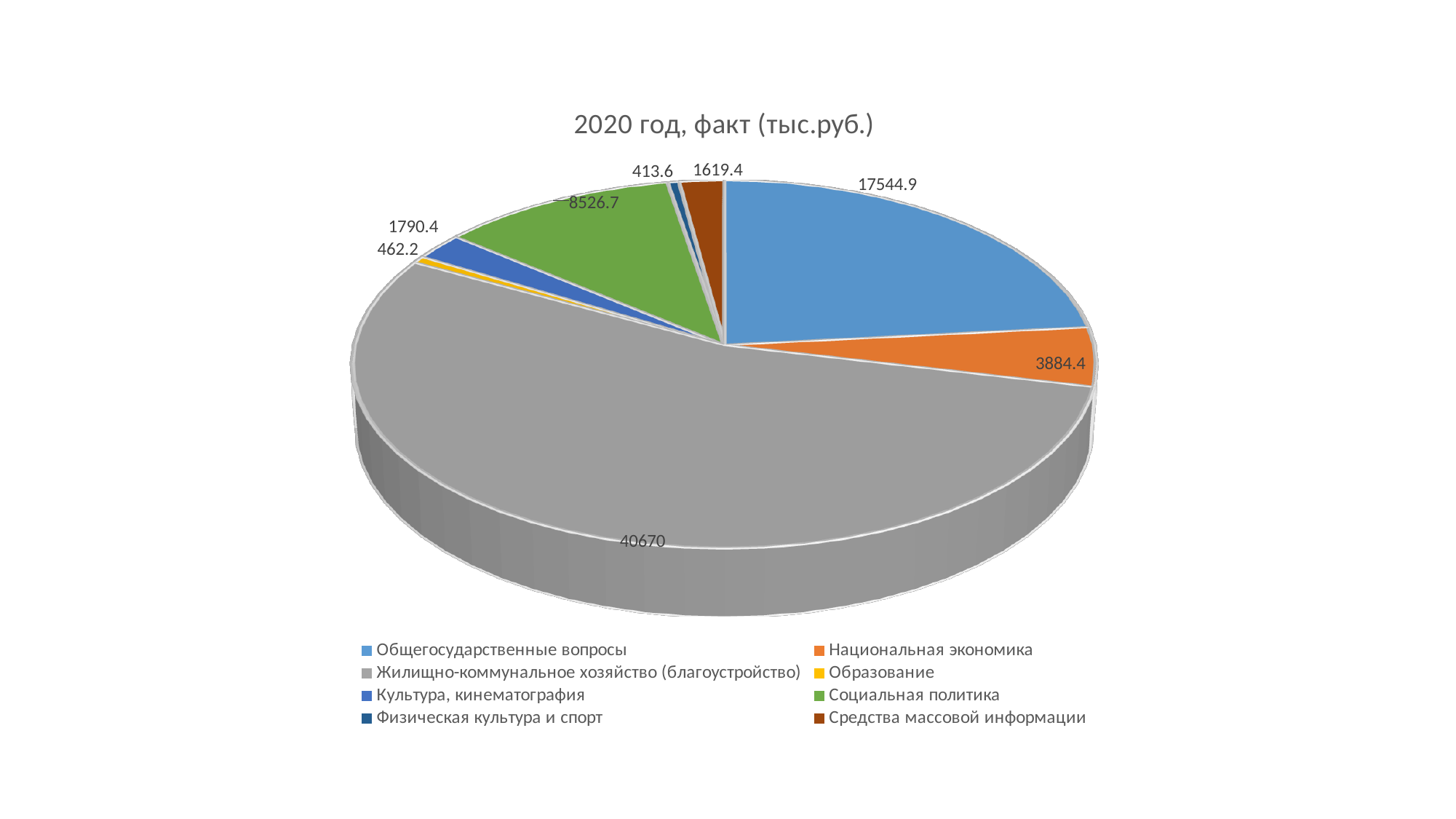
What is the difference between Общегосударственные вопросы and Национальная экономика? 13660.5 What share of the total does Жилищно-коммунальное хозяйство (благоустройство) represent? 54.3% What kind of chart is shown on the slide? Pie chart How many categories does the pie chart have? 8 What is the value for Средства массовой информации? 1619.4 What is the value for Жилищно-коммунальное хозяйство (благоустройство)? 40670 Which category has the largest slice? Жилищно-коммунальное хозяйство (благоустройство) Which is larger, Культура, кинематография or Средства массовой информации? Культура, кинематография Which category has the smallest slice? Физическая культура и спорт What is the title of the chart? 2020 год, факт (тыс.руб.) What is the value for Социальная политика? 8526.7 What is the value for Общегосударственные вопросы? 17544.9